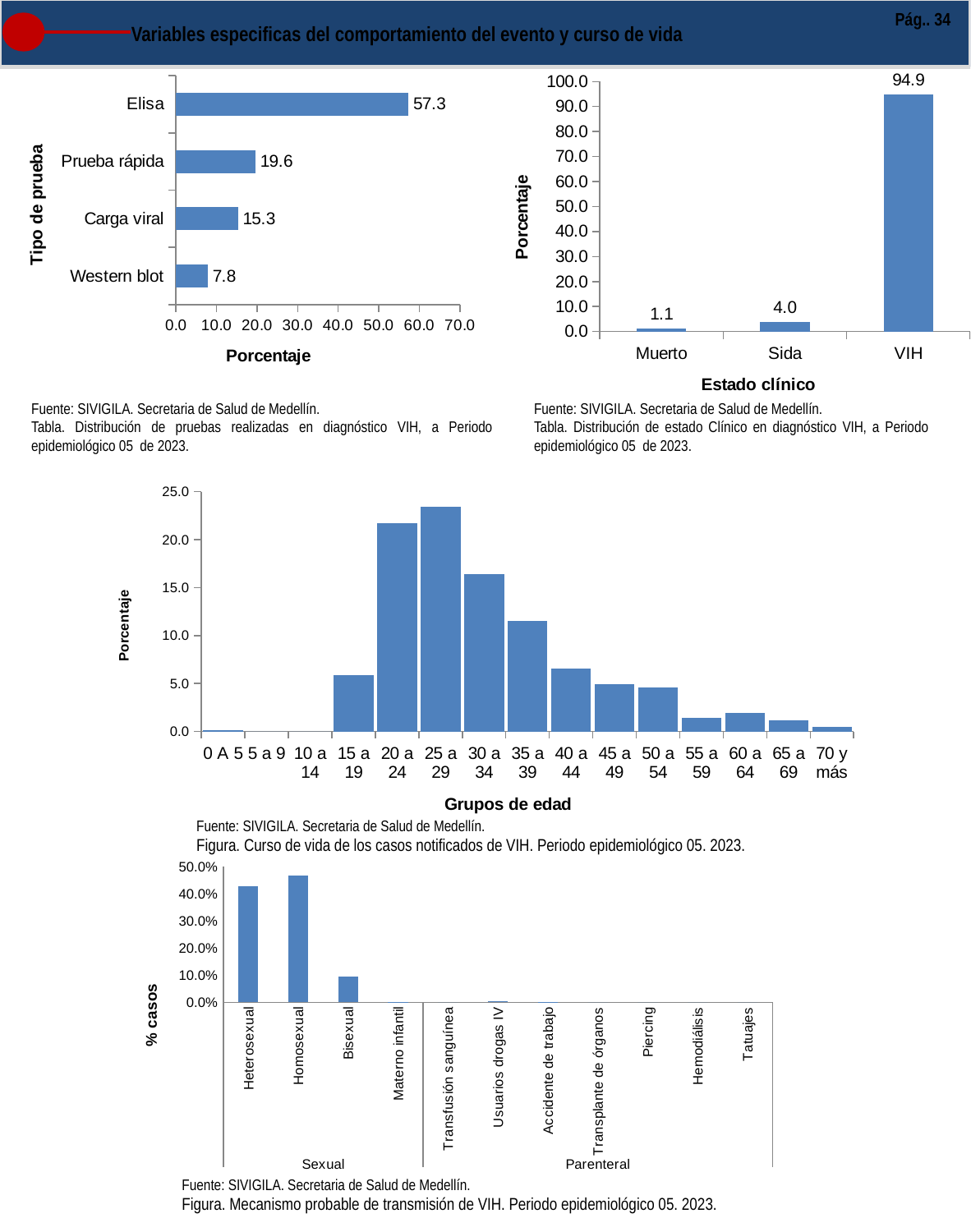
In the top-left chart (Tipo de prueba), which test type has the lowest percentage? Western blot In the middle chart (Grupos de edad), how many age groups are shown on the x axis? 15 In the middle chart (Grupos de edad), which age group has the highest percentage? 25 a 29 In the top-right chart (Estado clínico), what is the difference between VIH and Muerto? 93.8 In the top-right chart (Estado clínico), what is the value for Sida? 4.0 In the bottom chart (% casos by transmission mechanism), which category has the highest percentage? Homosexual In the top-left chart (Tipo de prueba), what is the value for Elisa? 57.3 In the middle chart (Grupos de edad), is the value for 30 a 34 greater or less than 15.0? greater In the top-right chart (Estado clínico), which clinical state has the highest percentage? VIH In the top-left chart (Tipo de prueba), what is the difference between Prueba rápida and Carga viral? 4.3 In the top-right chart (Estado clínico), how many categories are shown on the x axis? 3